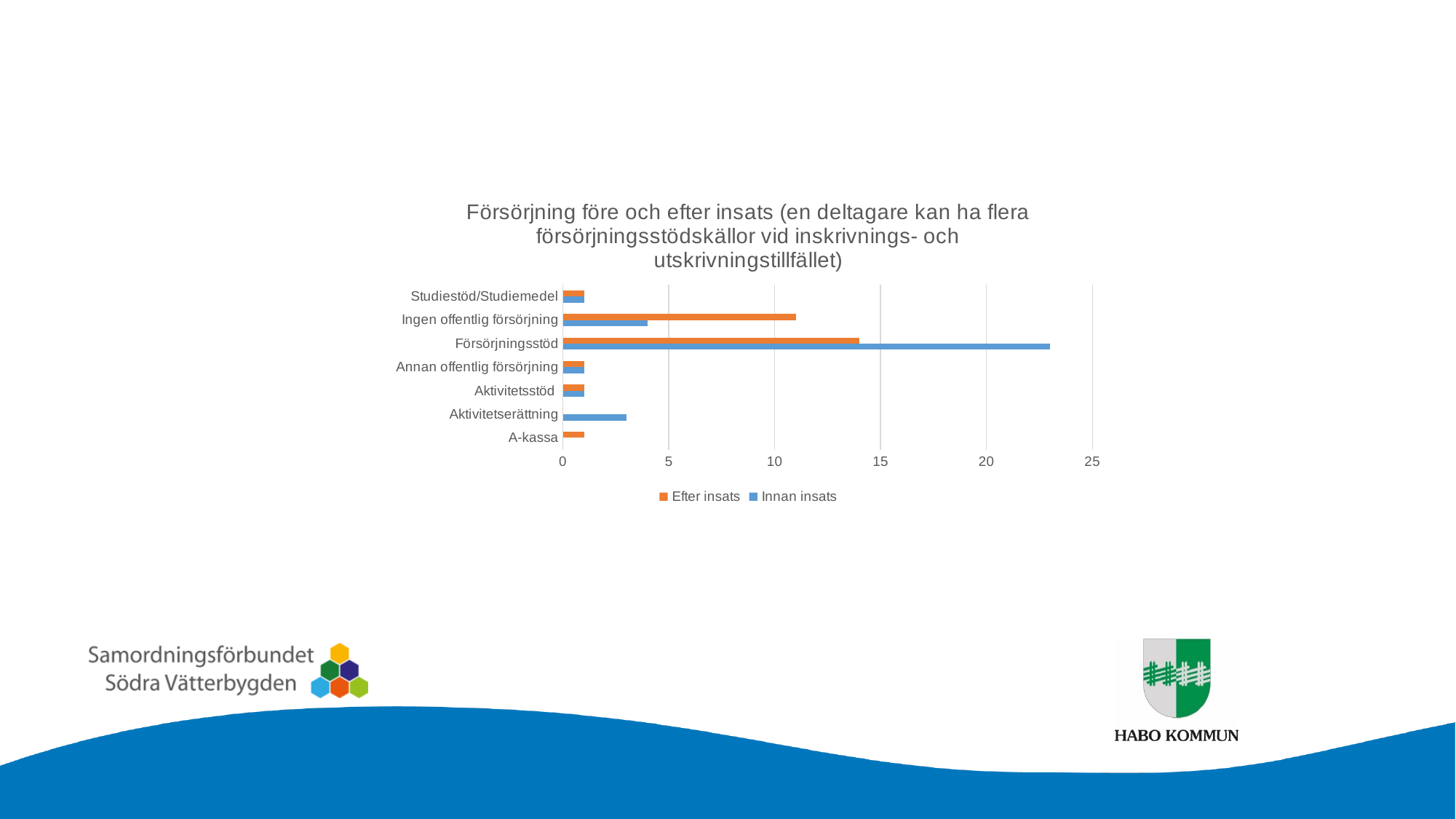
Is the Innan insats value for Försörjningsstöd greater or less than 20? greater Which category has no Innan insats bar at all? A-kassa Is the Innan insats value for Ingen offentlig försörjning greater or less than 5? less Which category has the highest value for the Innan insats series? Försörjningsstöd Which colour represents the Efter insats series in the legend? orange For Försörjningsstöd, which is larger: Innan insats or Efter insats? Innan insats How many series does the legend list? 2 What kind of chart is shown on the slide? bar chart Which category has the highest value for the Efter insats series? Försörjningsstöd For Ingen offentlig försörjning, which is larger: Innan insats or Efter insats? Efter insats Is the Efter insats value for Försörjningsstöd greater or less than 10? greater How many categories are shown on the vertical axis of the chart? 7